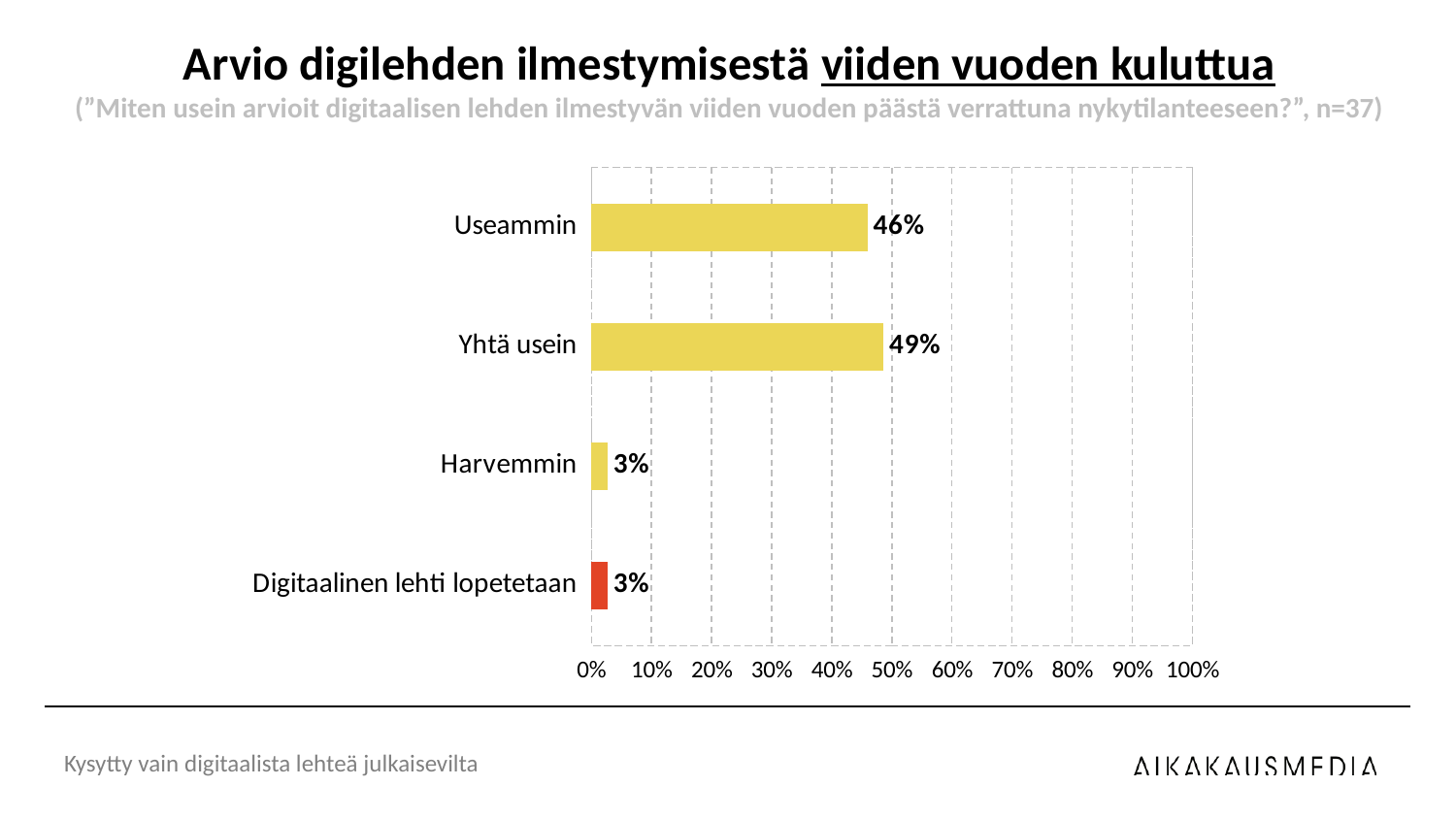
Which is larger, the value for Useammin or the value for Harvemmin? Useammin Which category's bar is coloured red instead of yellow? Digitaalinen lehti lopetetaan What is the difference between the values for Yhtä usein and Useammin? 3% What is the difference between the values for Useammin and Digitaalinen lehti lopetetaan? 43% What kind of chart is shown on the slide? Bar chart What is the value for Digitaalinen lehti lopetetaan? 3% Which category has the highest value? Yhtä usein What is the value for Useammin? 46% What is the value for Harvemmin? 3% What is the value for Yhtä usein? 49% How many categories are shown in the chart? 4 Is the value for Useammin greater or less than 40%? greater